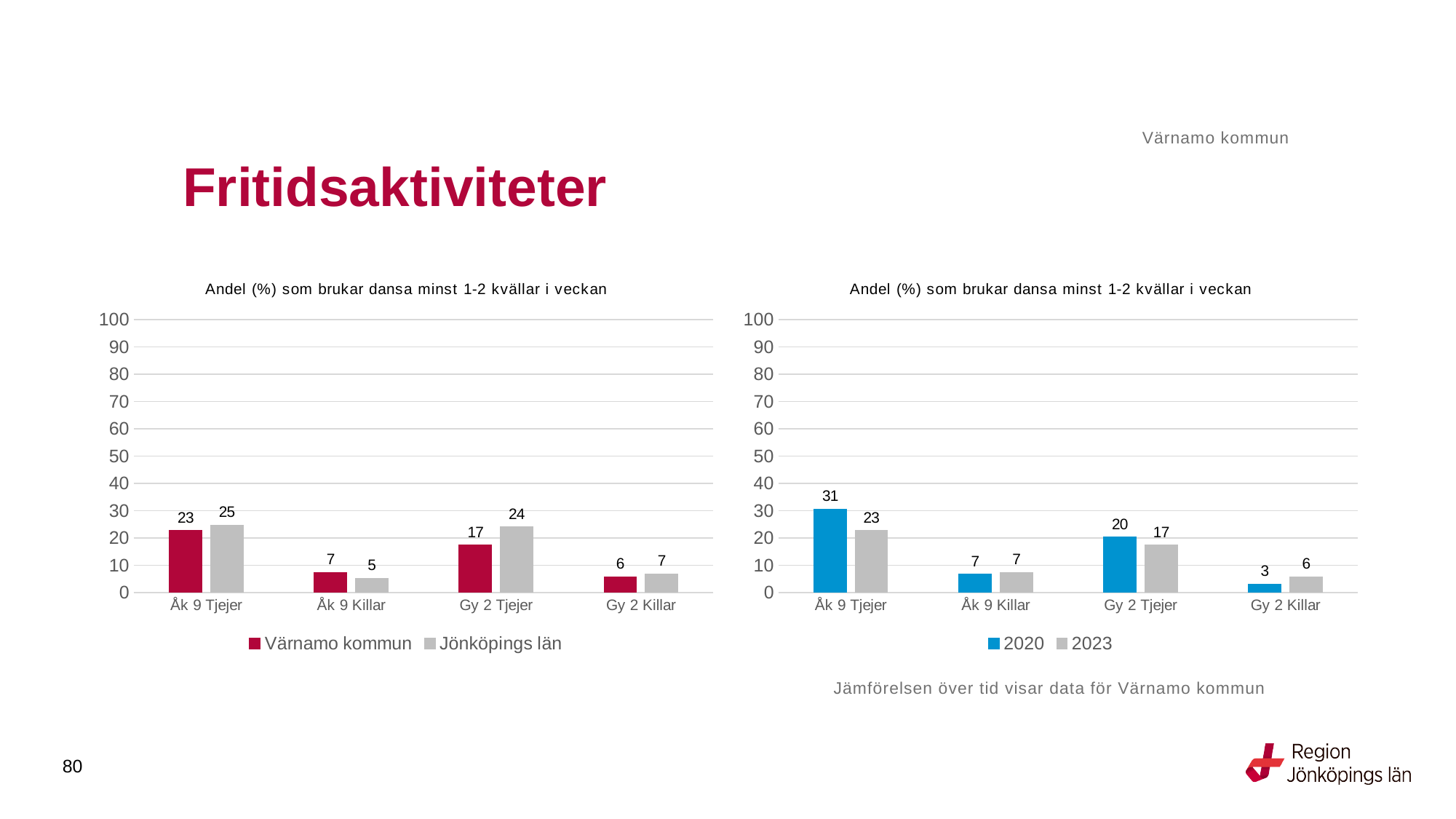
In the right chart, which category has the lowest value for 2020? Gy 2 Killar In the left chart, what is the value for Jönköpings län for Gy 2 Tjejer? 24 In the left chart, what is the difference between Jönköpings län and Värnamo kommun for Gy 2 Tjejer? 7 In the left chart, which is larger for Åk 9 Killar: Värnamo kommun or Jönköpings län? Värnamo kommun In the right chart, what is the difference between 2020 and 2023 for Åk 9 Tjejer? 8 In the right chart, what is the value for 2020 for Åk 9 Tjejer? 31 How many series does the legend of the left chart list? 2 In the left chart, which category has the highest value for Jönköpings län? Åk 9 Tjejer In the left chart, what is the value for Värnamo kommun for Åk 9 Tjejer? 23 In the right chart, what is the value for 2023 for Gy 2 Killar? 6 What type of chart is the right chart? Bar chart How many categories are shown on the x axis of the right chart? 4